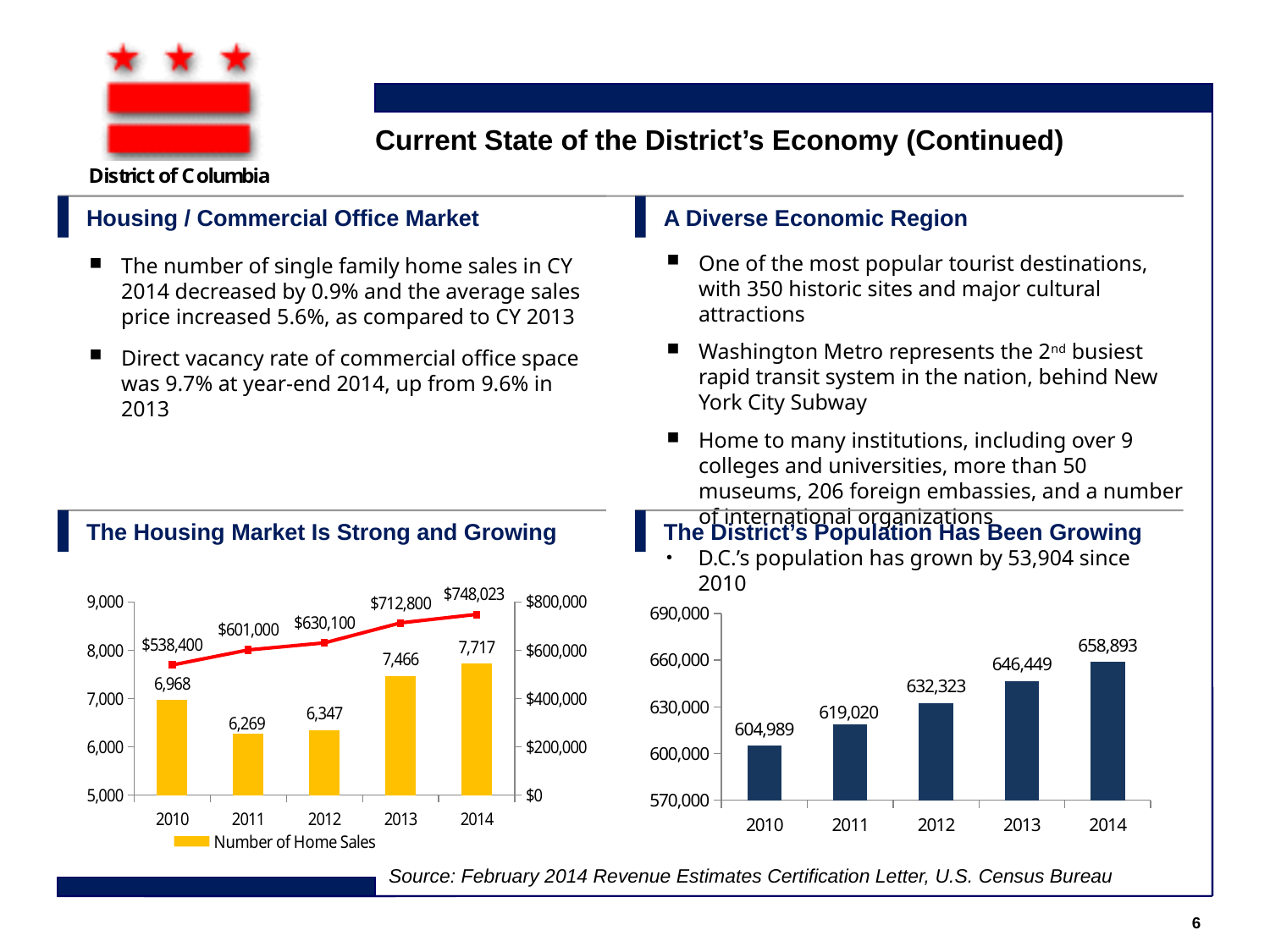
In the chart titled 'The Housing Market Is Strong and Growing', how many years are shown on the x axis? 5 What kind of chart is 'The District's Population Has Been Growing'? bar chart In the chart titled 'The District's Population Has Been Growing', what is the difference between the 2014 and 2010 values? 53,904 In the chart titled 'The Housing Market Is Strong and Growing', what value does the line show for 2014? $748,023 In the chart titled 'The Housing Market Is Strong and Growing', which year has the lowest number of home sales? 2011 In the chart titled 'The District's Population Has Been Growing', is the value for 2011 greater or less than 630,000? less In the chart titled 'The Housing Market Is Strong and Growing', what is the only entry shown in the legend? Number of Home Sales In the chart titled 'The Housing Market Is Strong and Growing', which year has the highest number of home sales? 2014 In the chart titled 'The District's Population Has Been Growing', do the values rise or fall from 2010 to 2014? rise In the chart titled 'The Housing Market Is Strong and Growing', what is the number of home sales in 2013? 7,466 In the chart titled 'The Housing Market Is Strong and Growing', what is the difference in the number of home sales between 2014 and 2013? 251 In the chart titled 'The District's Population Has Been Growing', what is the population value for 2012? 632,323